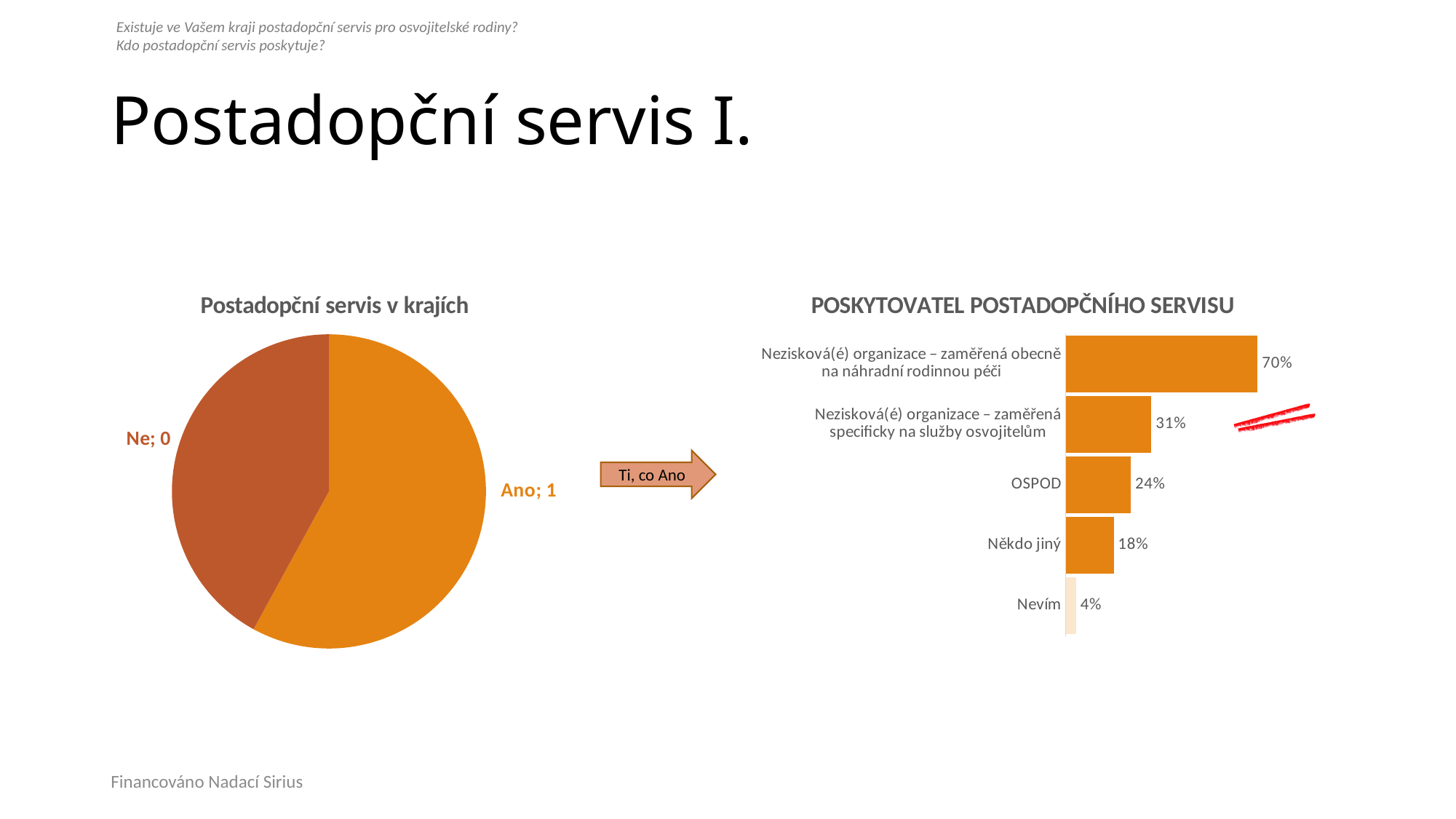
In the chart titled 'POSKYTOVATEL POSTADOPČNÍHO SERVISU', which category has the highest value? Nezisková(é) organizace – zaměřená obecně na náhradní rodinnou péči In the pie chart titled 'Postadopční servis v krajích', which slice is larger: 'Ano' or 'Ne'? Ano In the chart titled 'POSKYTOVATEL POSTADOPČNÍHO SERVISU', what is the value for 'Někdo jiný'? 18% What kind of chart is the chart titled 'Postadopční servis v krajích'? Pie chart In the chart titled 'POSKYTOVATEL POSTADOPČNÍHO SERVISU', what is the value for OSPOD? 24% In the chart titled 'POSKYTOVATEL POSTADOPČNÍHO SERVISU', what is the value for 'Nezisková(é) organizace – zaměřená specificky na služby osvojitelům'? 31% In the chart titled 'POSKYTOVATEL POSTADOPČNÍHO SERVISU', what is the value for 'Nevím'? 4% In the chart titled 'POSKYTOVATEL POSTADOPČNÍHO SERVISU', which is larger: the value for OSPOD or the value for 'Někdo jiný'? OSPOD In the chart titled 'POSKYTOVATEL POSTADOPČNÍHO SERVISU', what is the difference between the value for 'Nezisková(é) organizace – zaměřená obecně na náhradní rodinnou péči' and the value for OSPOD? 46% What kind of chart is the chart titled 'POSKYTOVATEL POSTADOPČNÍHO SERVISU'? Bar chart In the chart titled 'POSKYTOVATEL POSTADOPČNÍHO SERVISU', which category has the lowest value? Nevím How many categories are shown in the chart titled 'POSKYTOVATEL POSTADOPČNÍHO SERVISU'? 5